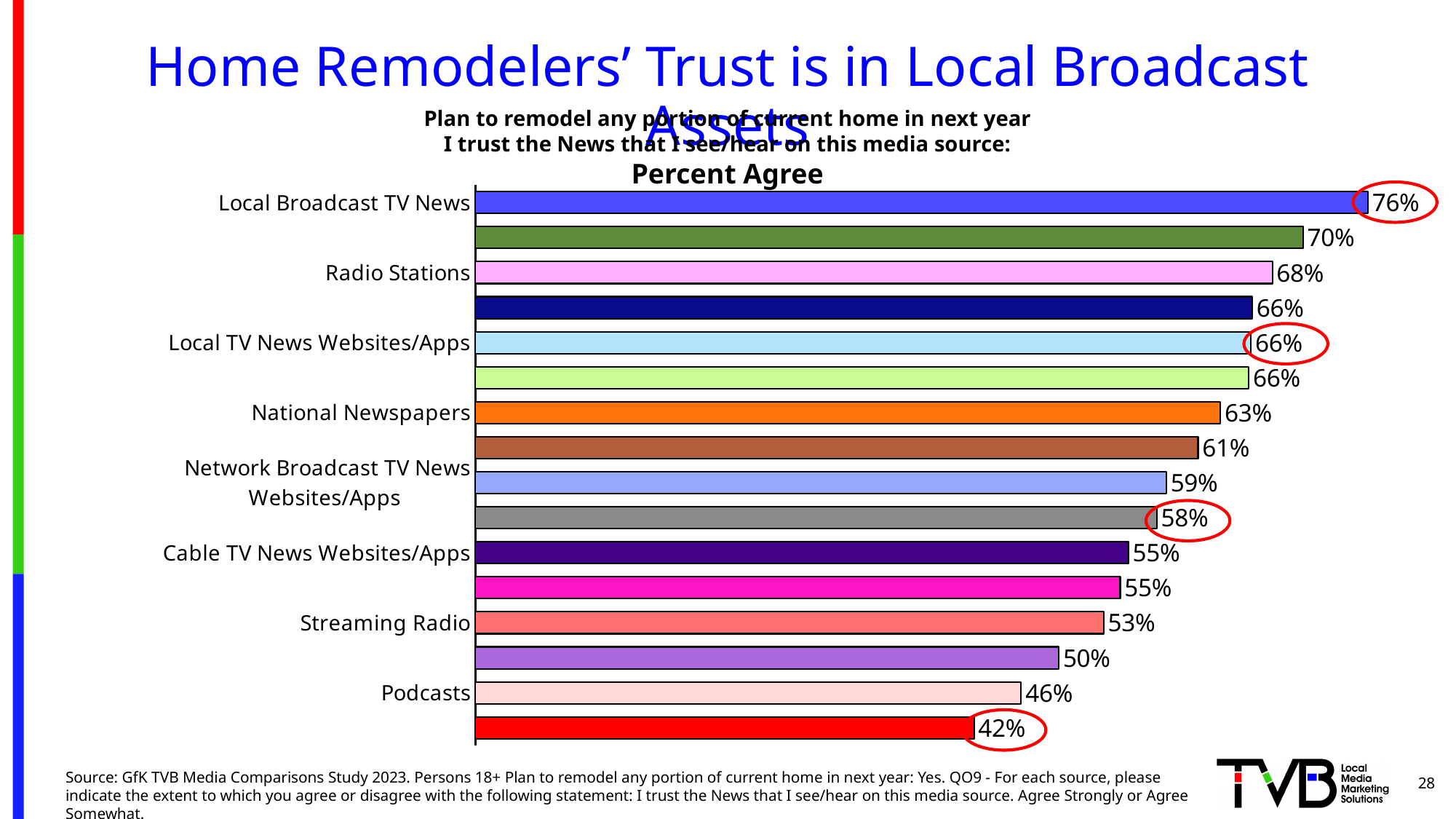
What percent of home remodelers agree they trust the news on Local Broadcast TV News? 76% What is the difference in Percent Agree between Local Broadcast TV News and Radio Stations? 8 percentage points What is the Percent Agree value for Podcasts? 46% What type of chart is shown on the slide? Bar chart What is the Percent Agree value for National Newspapers? 63% What is the Percent Agree value for Network Broadcast TV News Websites/Apps? 59% How many bars are plotted on the chart? 16 What is the Percent Agree value for Local TV News Websites/Apps? 66% What is the lowest Percent Agree value shown on the chart? 42% What is the Percent Agree value for Radio Stations? 68% Which has a higher Percent Agree value, Streaming Radio or Podcasts? Streaming Radio Which media source has the highest Percent Agree value? Local Broadcast TV News